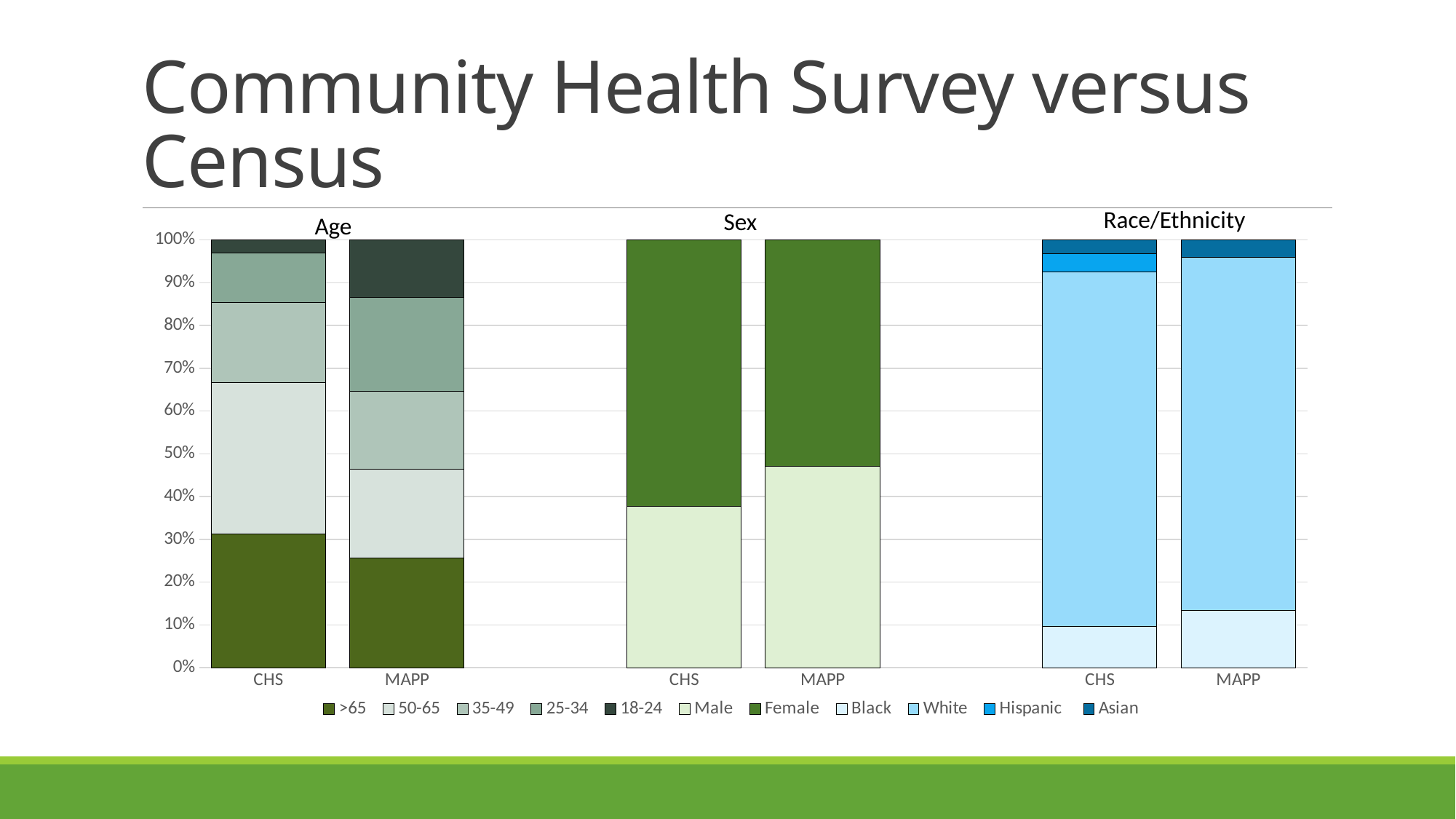
What are the three group headings shown above the bars? Age, Sex, Race/Ethnicity In the Age group, which bar has the larger 18-24 share, CHS or MAPP? MAPP In the Age group, is the >65 share for MAPP greater or less than 30%? less What does each stacked bar total on the y axis? 100% In the Age group, is the >65 share for CHS greater or less than 20%? greater In the Sex group, which bar has the larger Male share, CHS or MAPP? MAPP What kind of chart is shown on the slide? Stacked bar chart In the Sex group, is the Male share for MAPP greater or less than 50%? less How many bars are plotted in the chart? 6 Which legend entry is listed last? Asian How many series does the legend list? 11